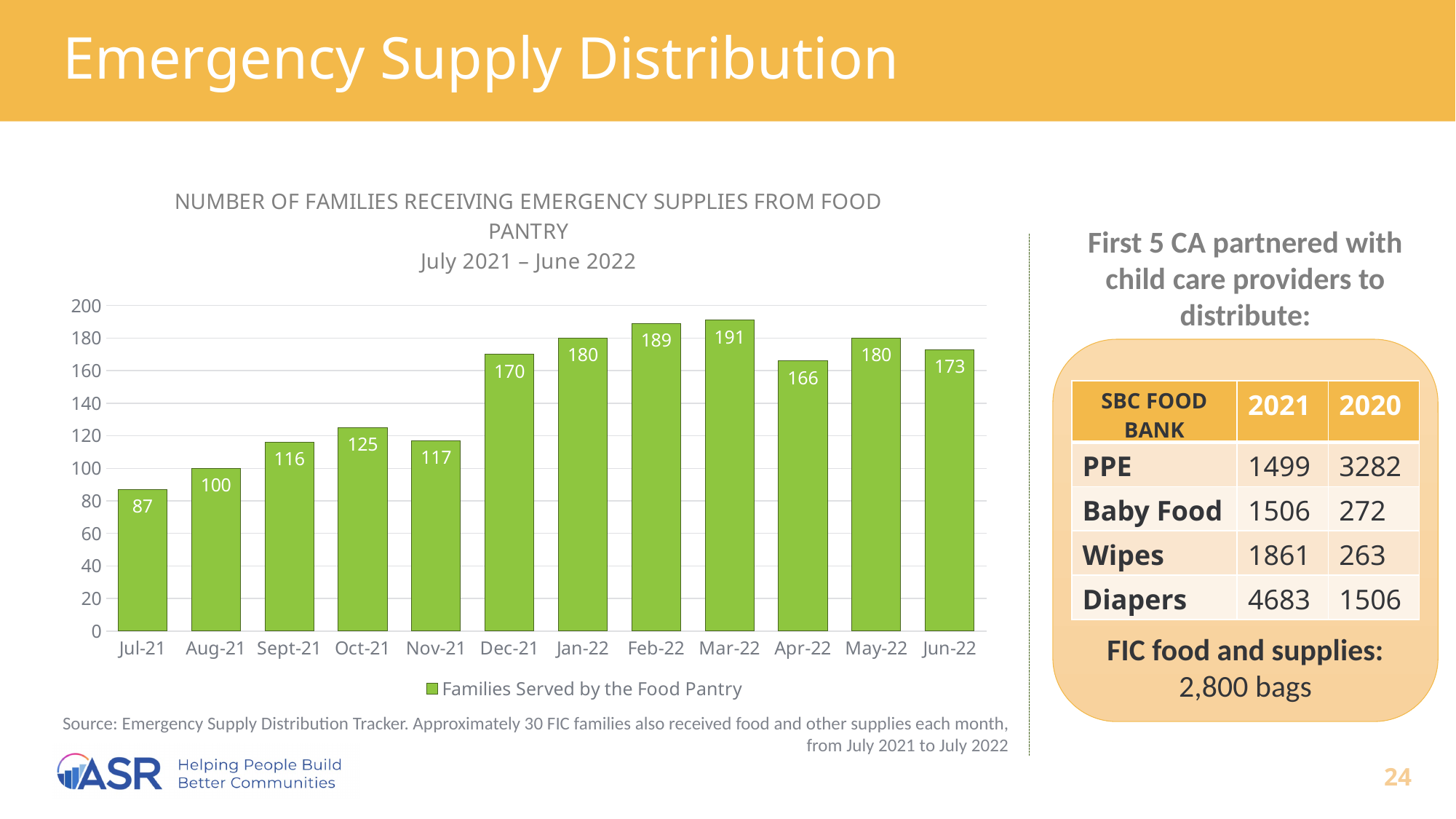
Which is larger, the value for Oct-21 or the value for Nov-21? Oct-21 Which month has the highest number of families served by the food pantry? Mar-22 What is the value for Jul-21 in the chart? 87 Do the values generally rise or fall from Jul-21 to Mar-22? rise How many families were served by the food pantry in Mar-22? 191 What is the legend entry for the series in the chart? Families Served by the Food Pantry How many series does the chart legend list? 1 Which month has the lowest number of families served by the food pantry? Jul-21 What is the difference between the values for Mar-22 and Apr-22? 25 What kind of chart is shown on the slide? bar chart Is the value for Dec-21 greater or less than 160? greater How many months are shown on the x axis of the chart? 12